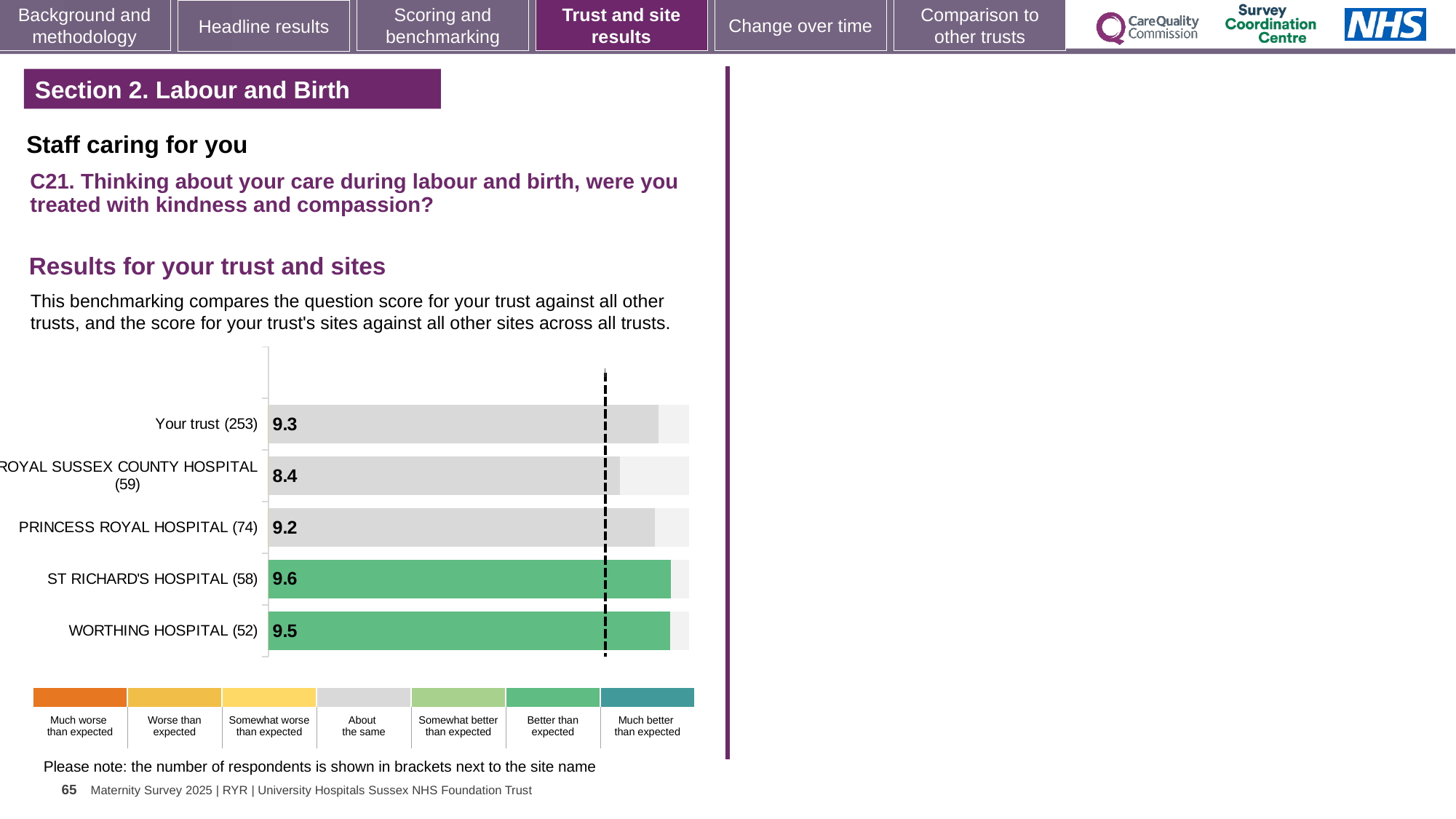
How many bars are shown in the chart? 5 What is the score for St Richard's Hospital? 9.6 What is the score for Your trust? 9.3 How many respondents are shown in brackets for Your trust? 253 What is the difference between the scores for St Richard's Hospital and Royal Sussex County Hospital? 1.2 What is the score for Worthing Hospital? 9.5 Which has the higher score, Worthing Hospital or Princess Royal Hospital? Worthing Hospital Which site has the highest score? St Richard's Hospital What is the score for Princess Royal Hospital? 9.2 Which site has the lowest score? Royal Sussex County Hospital What kind of chart is shown on the slide? Bar chart What is the score for Royal Sussex County Hospital? 8.4